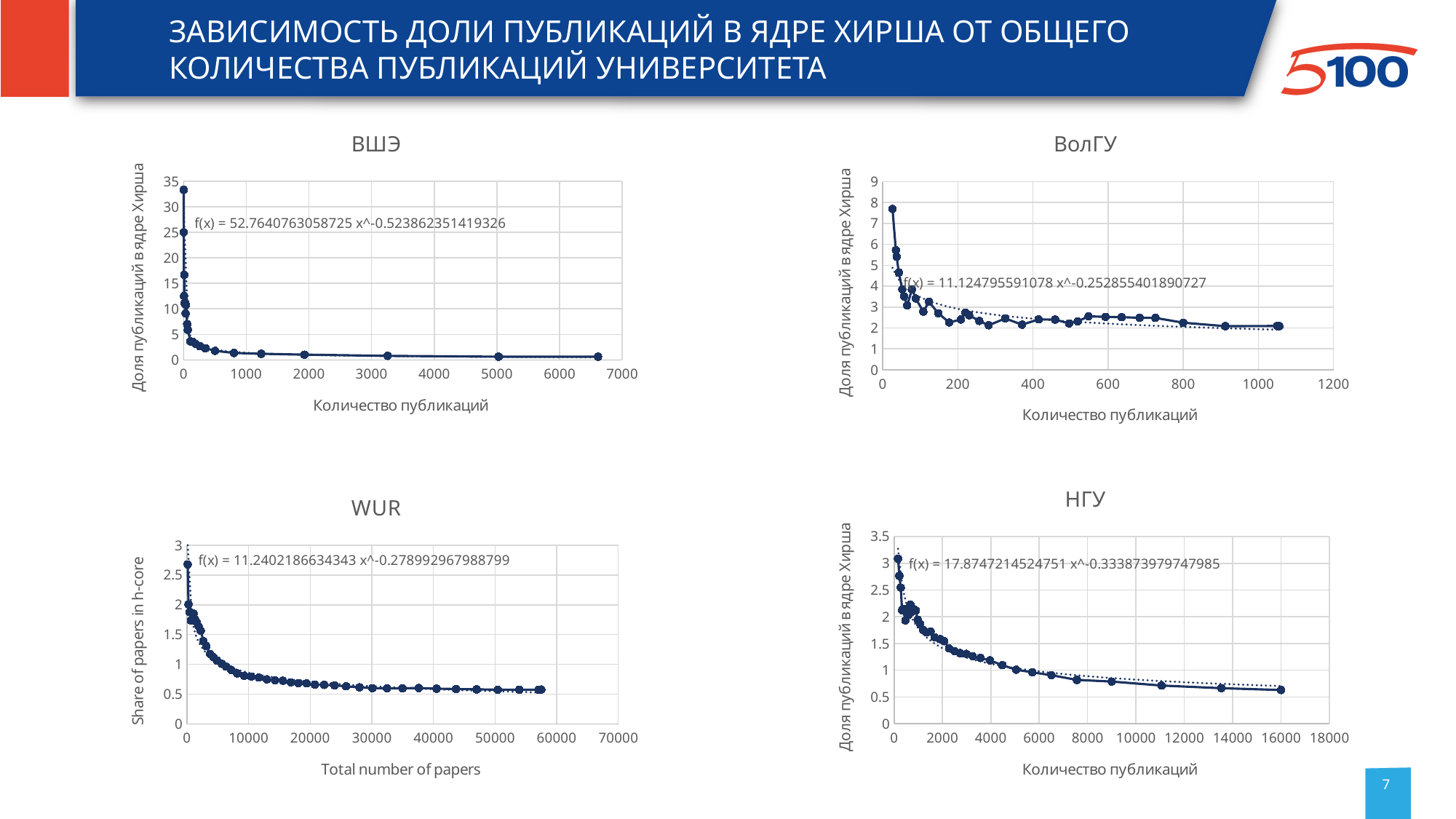
In the НГУ chart, do the values rise or fall along the x axis? fall How many charts are shown on the slide? 4 What kind of chart is the ВШЭ chart? scatter chart In the ВШЭ chart, is the value for the rightmost point (around 6600 publications) greater or less than 5? less In the WUR chart, is the value for the rightmost point (around 57000 papers) greater or less than 1? less What is the trendline equation shown on the ВШЭ chart? f(x) = 52.7640763058725 x^-0.523862351419326 In the ВШЭ chart, do the values rise or fall as the number of publications increases? fall In the ВолГУ chart, is the value for the leftmost point greater or less than 7? greater What is the x-axis label of the WUR chart? Total number of papers